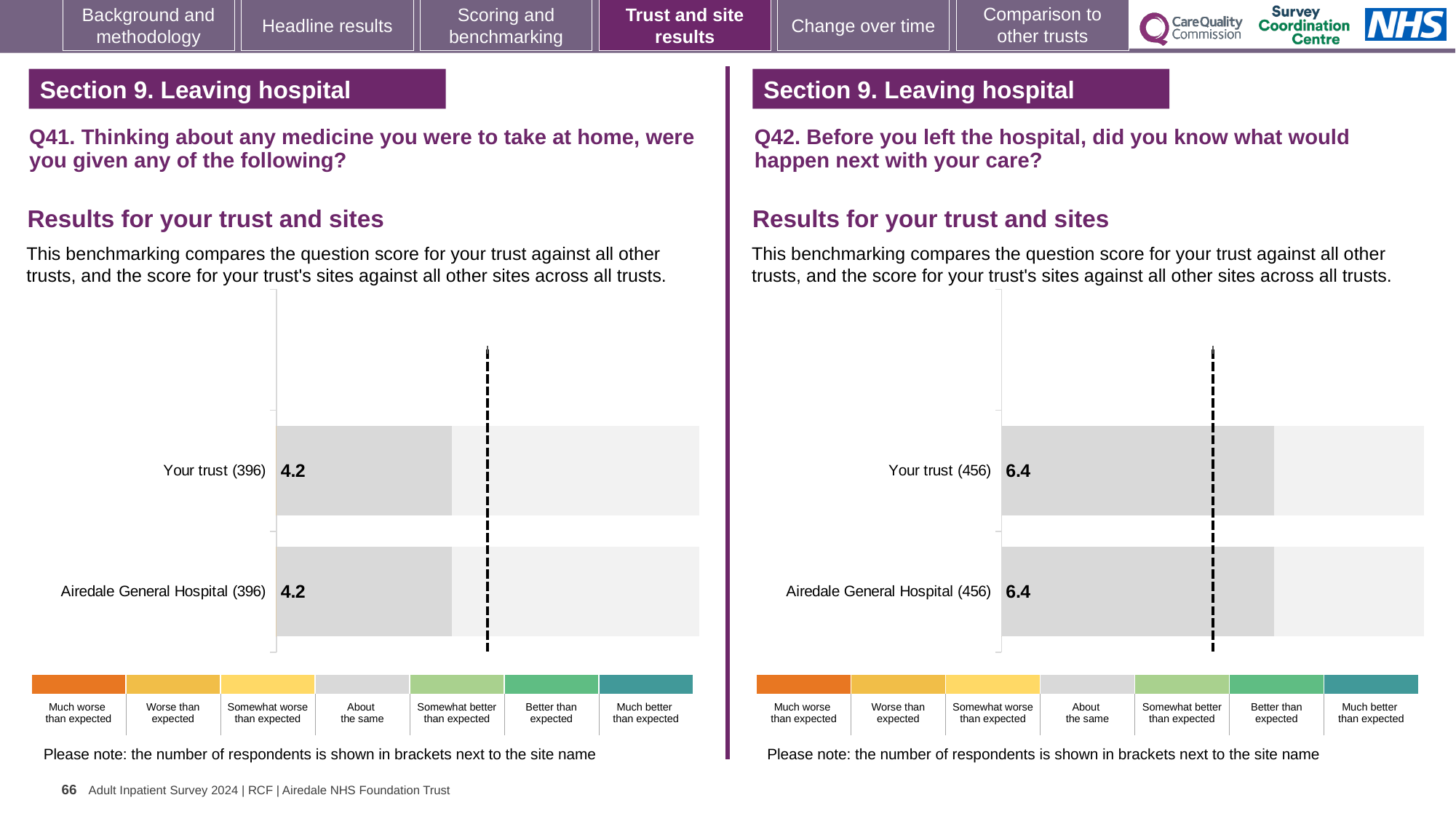
In the Q41 chart on the left, how many respondents are shown in brackets next to Your trust? 396 How many bars are plotted in the Q41 chart on the left? 2 What kind of chart is used for the Q42 results on the right? Bar chart How many bars are plotted in the Q42 chart on the right? 2 In the Q42 chart on the right, what is the score for Your trust? 6.4 In the Q41 chart on the left, what is the score for Airedale General Hospital? 4.2 In the Q41 chart on the left, what is the score for Your trust? 4.2 In the Q42 chart on the right, how many respondents are shown in brackets next to Airedale General Hospital? 456 How many categories does the colour key below the Q41 chart on the left list? 7 In the Q42 chart on the right, what is the score for Airedale General Hospital? 6.4 In the Q41 chart on the left, what is the difference between the score for Your trust and the score for Airedale General Hospital? 0 In the Q42 chart on the right, what is the difference between the score for Your trust and the score for Airedale General Hospital? 0